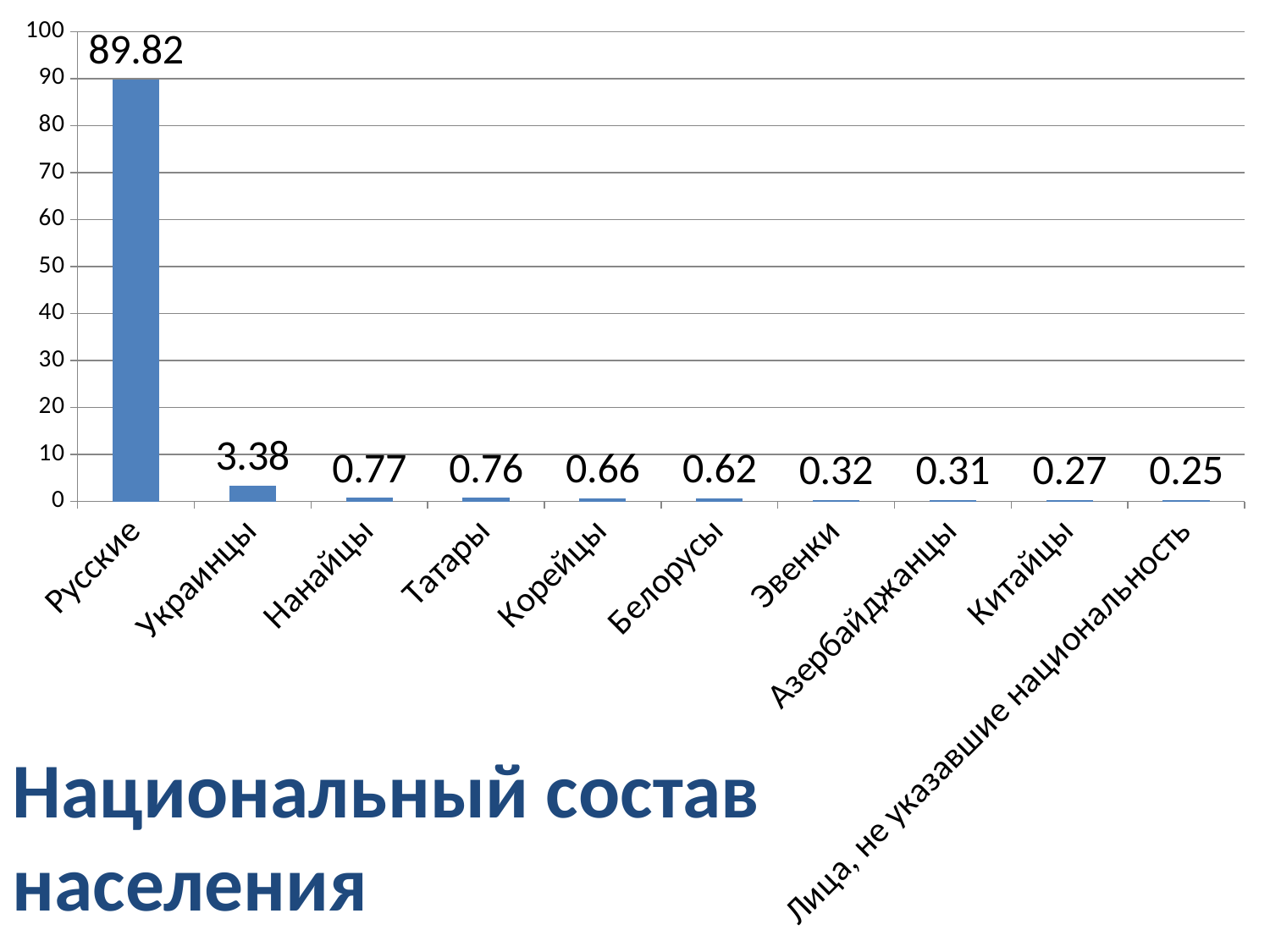
What kind of chart is shown on the slide? bar chart What is the difference between the values for Русские and Украинцы? 86.44 How many categories are shown on the x axis? 10 What is the value for Русские? 89.82 What is the value for Украинцы? 3.38 Is the value for Русские greater or less than 80? greater Do the values rise or fall from left to right along the x axis? fall Which category has the lowest value? Лица, не указавшие национальность What is the value for Лица, не указавшие национальность? 0.25 What is the value for Корейцы? 0.66 Which is larger, the value for Татары or the value for Белорусы? Татары Which category has the highest value? Русские